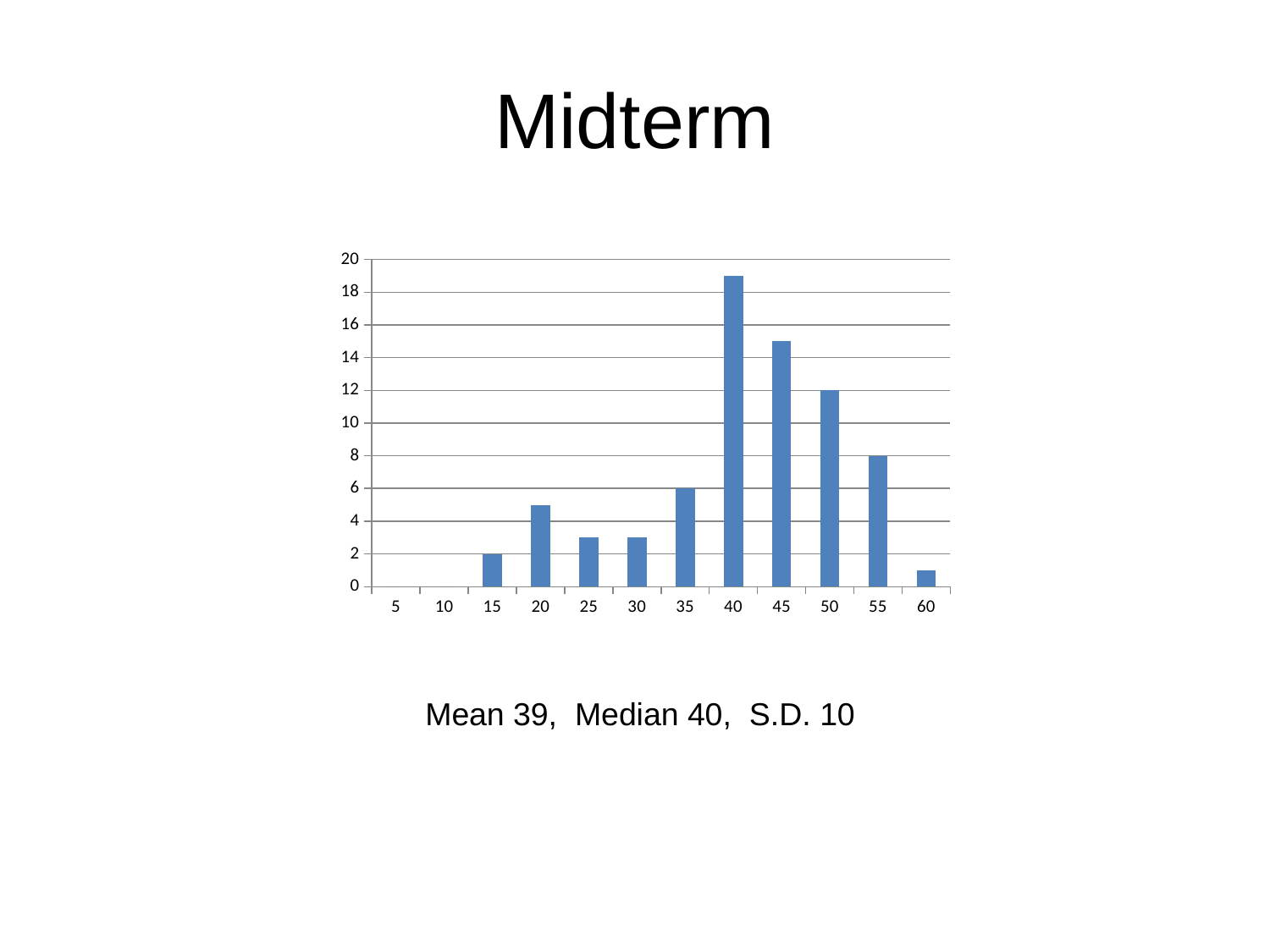
What kind of chart is shown on the slide? bar chart Is the value for category 40 greater or less than 18? greater Which has the larger value, category 45 or category 50? 45 What is the value of the bar for category 55? 8 Which category has the highest bar in the chart? 40 How many categories are shown on the x axis of the chart? 12 Is the value for category 60 greater or less than 2? less What is the title of the chart on the slide? Midterm What is the value of the bar for category 15? 2 What is the value of the bar for category 35? 6 What is the difference between the values for categories 50 and 55? 4 What is the value of the bar for category 50? 12